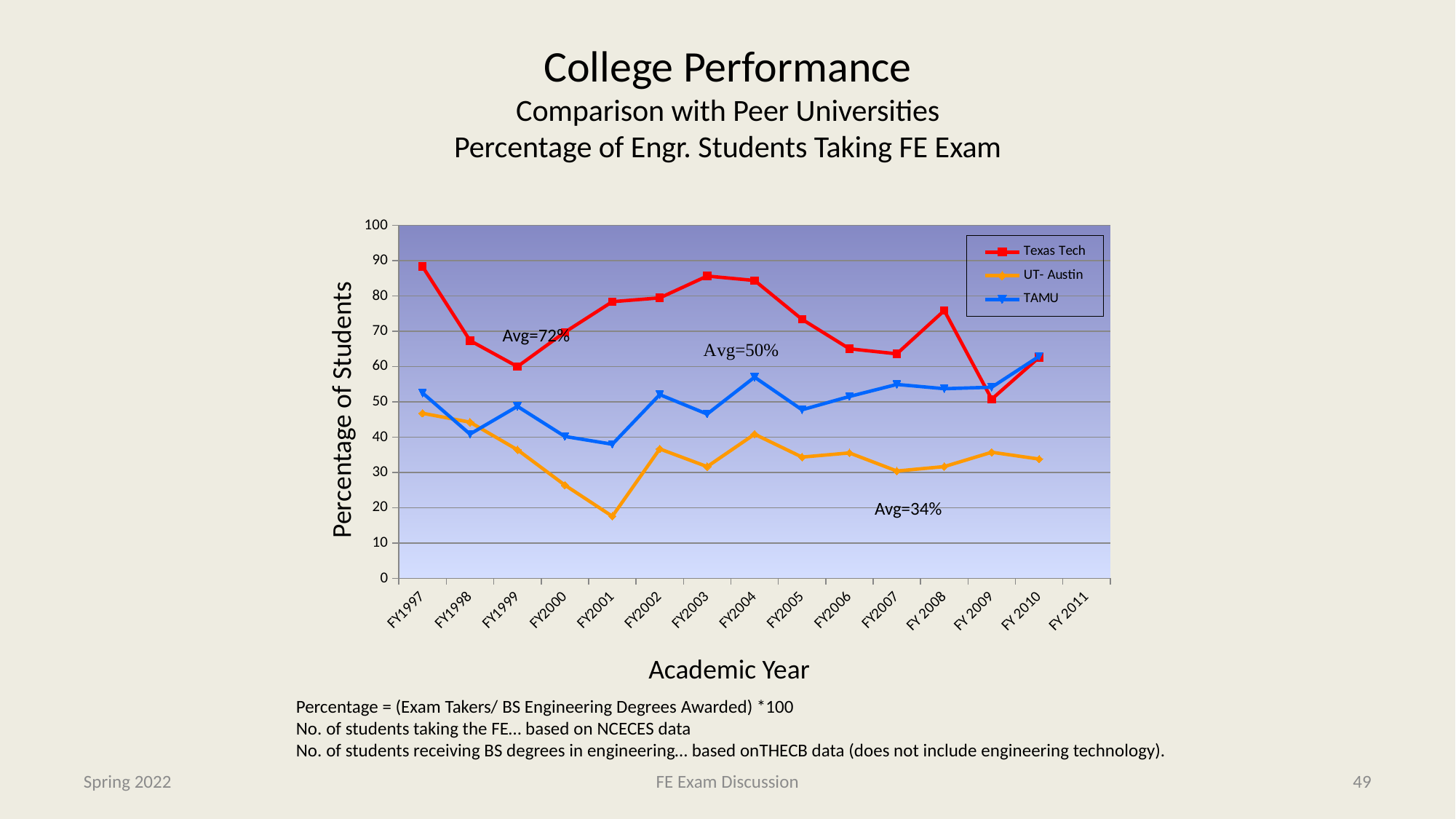
In which academic year is the TAMU value highest? FY 2010 Is the value for Texas Tech in FY1997 greater or less than 80? greater In FY2000, which is larger: the Texas Tech value or the UT- Austin value? Texas Tech What average is annotated for the Texas Tech series? Avg=72% Does the UT- Austin line rise or fall from FY1997 to FY2001? Fall Is the value for UT- Austin in FY2001 greater or less than 20? less How many academic year labels are shown on the x axis? 15 In which academic year is the UT- Austin value lowest? FY2001 What kind of chart is shown on the slide? Line chart Is the value for TAMU in FY2001 greater or less than 40? less How many series does the legend list? 3